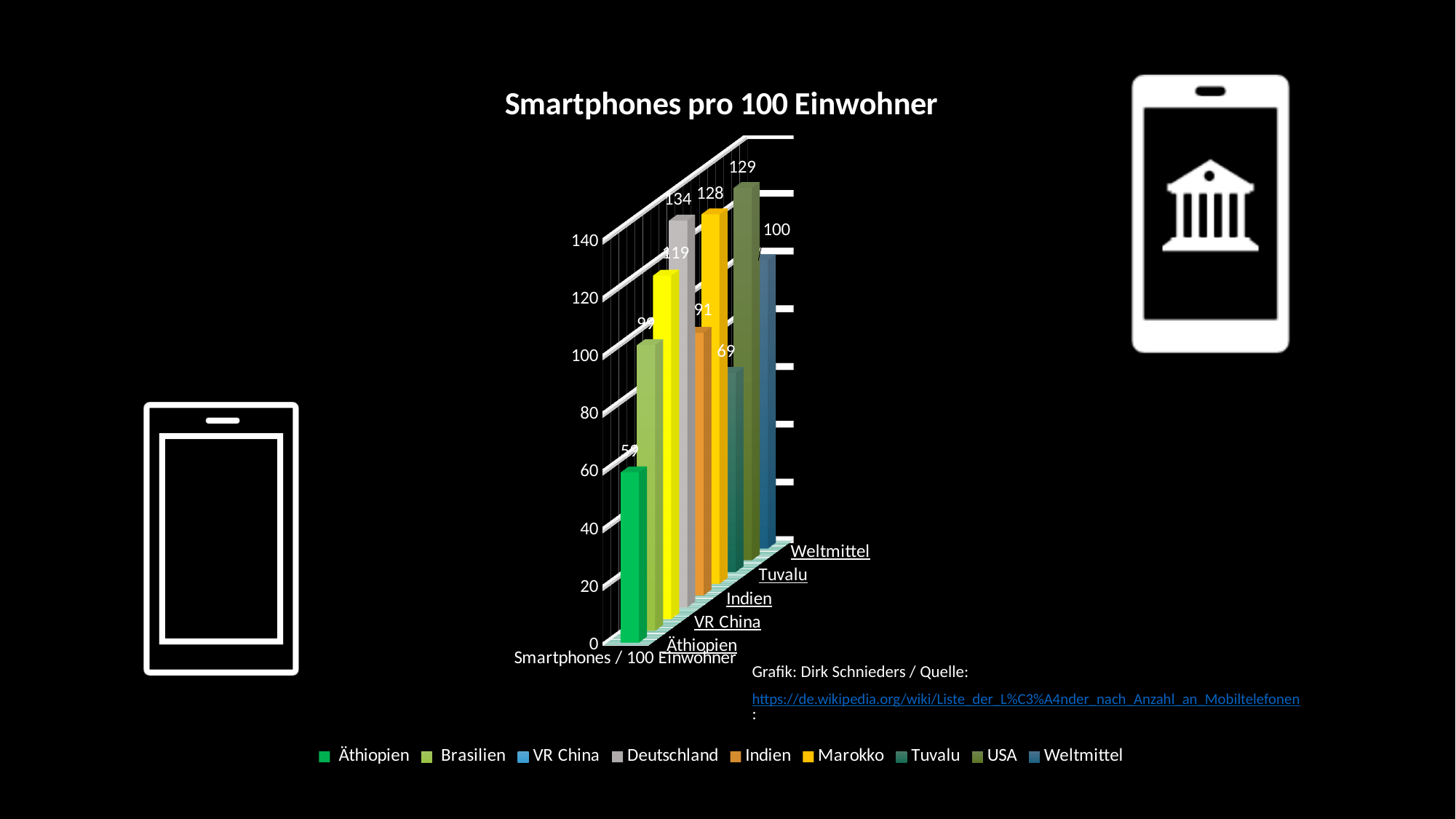
Which category has the lowest value in the chart? Äthiopien What is the value for Deutschland in the chart? 134 What is the value for VR China in the chart? 119 Is the value for Brasilien greater or less than 80? greater What kind of chart is shown on the slide? bar chart Which is larger, the value for Indien or the value for VR China? VR China What is the value for Tuvalu in the chart? 69 Which category has the highest value in the chart? Deutschland How many categories are plotted in the chart? 9 What is the difference between the values for Deutschland and Weltmittel? 34 What is the title of the chart? Smartphones pro 100 Einwohner What is the value for Weltmittel in the chart? 100